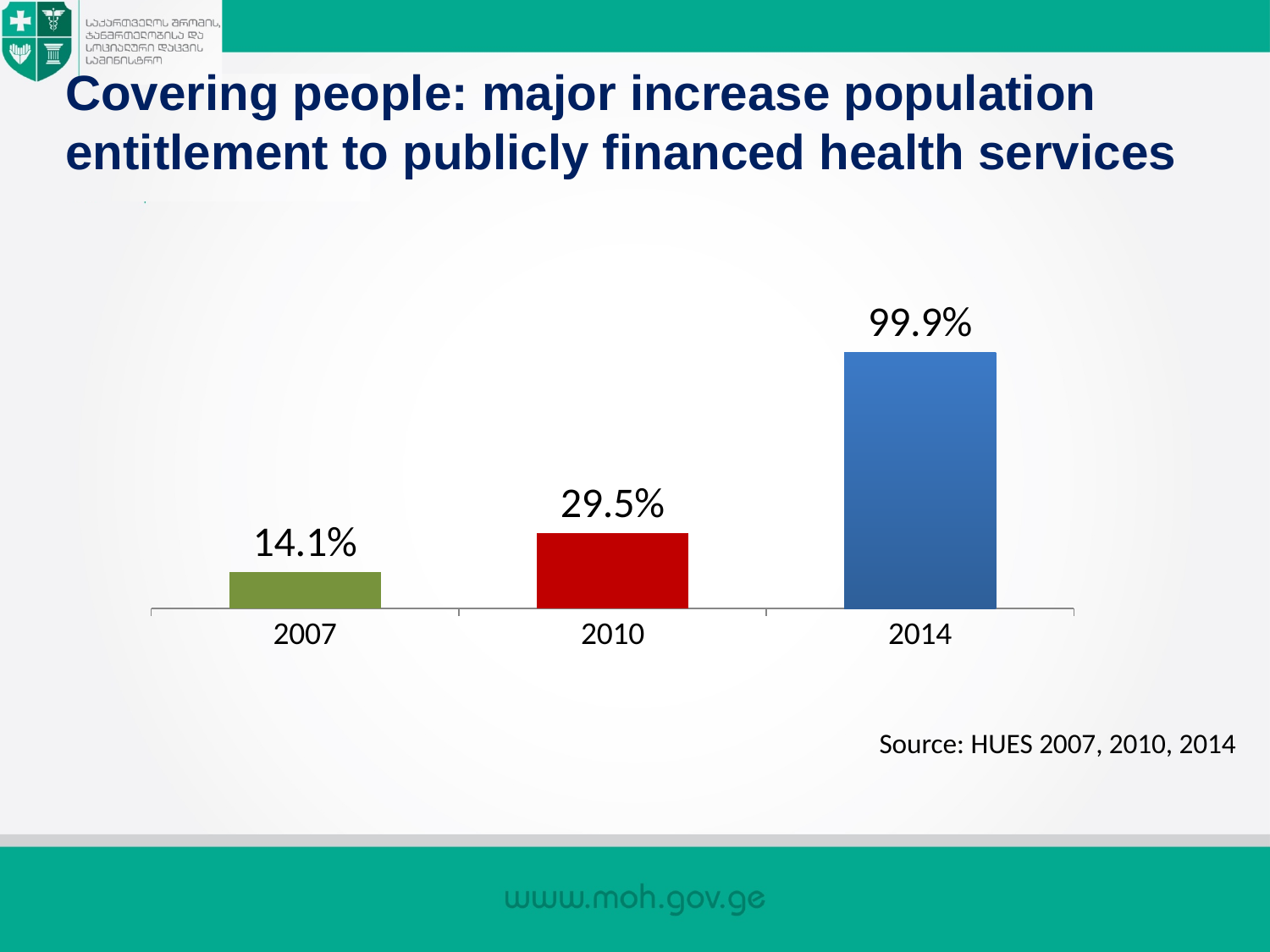
Do the values rise or fall from 2007 to 2014? Rise How many years are shown on the chart? 3 What is the value shown for 2014? 99.9% Which is larger, the value for 2010 or the value for 2007? 2010 What is the difference between the values for 2010 and 2007? 15.4% What colour is the bar for 2010? Red Which year has the lowest value? 2007 What is the difference between the values for 2014 and 2010? 70.4% Which year has the highest value? 2014 What is the value shown for 2010? 29.5% What kind of chart is shown on the slide? Bar chart What is the value shown for 2007? 14.1%